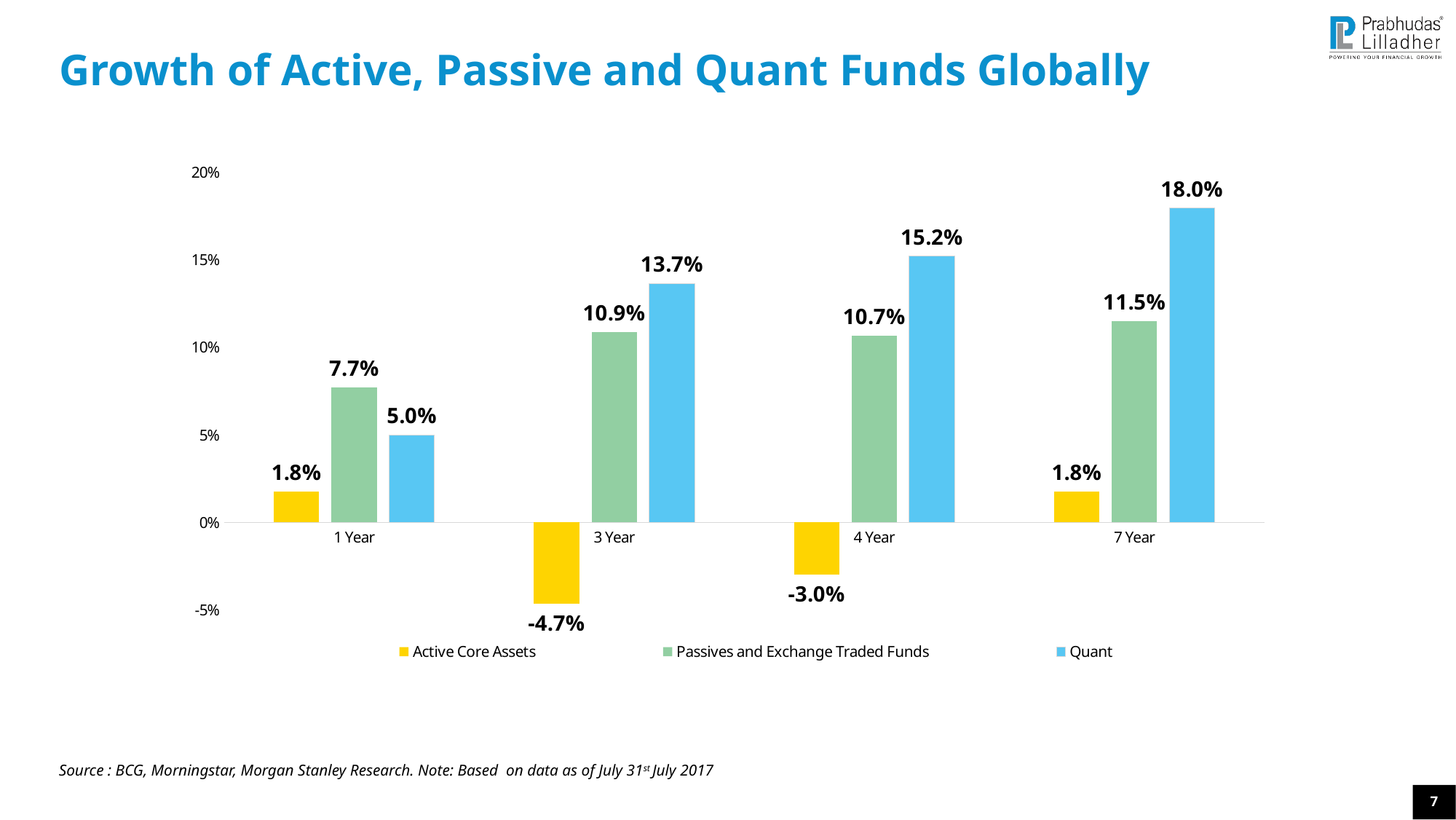
How many periods are shown on the x axis? 4 What is the value for Active Core Assets at 3 Year? -4.7% Which is larger at 1 Year: Passives and Exchange Traded Funds or Quant? Passives and Exchange Traded Funds What is the value for Quant at 7 Year? 18.0% Which period has the lowest value for Active Core Assets? 3 Year What kind of chart is shown on the slide? Bar chart What is the value for Passives and Exchange Traded Funds at 4 Year? 10.7% Is the value for Quant at 4 Year greater or less than 15%? greater How many series does the legend list? 3 Which period has the highest value for Quant? 7 Year Do the Quant values rise or fall from 1 Year to 7 Year? Rise What is the difference between the Quant and Passives and Exchange Traded Funds values at 3 Year? 2.8%